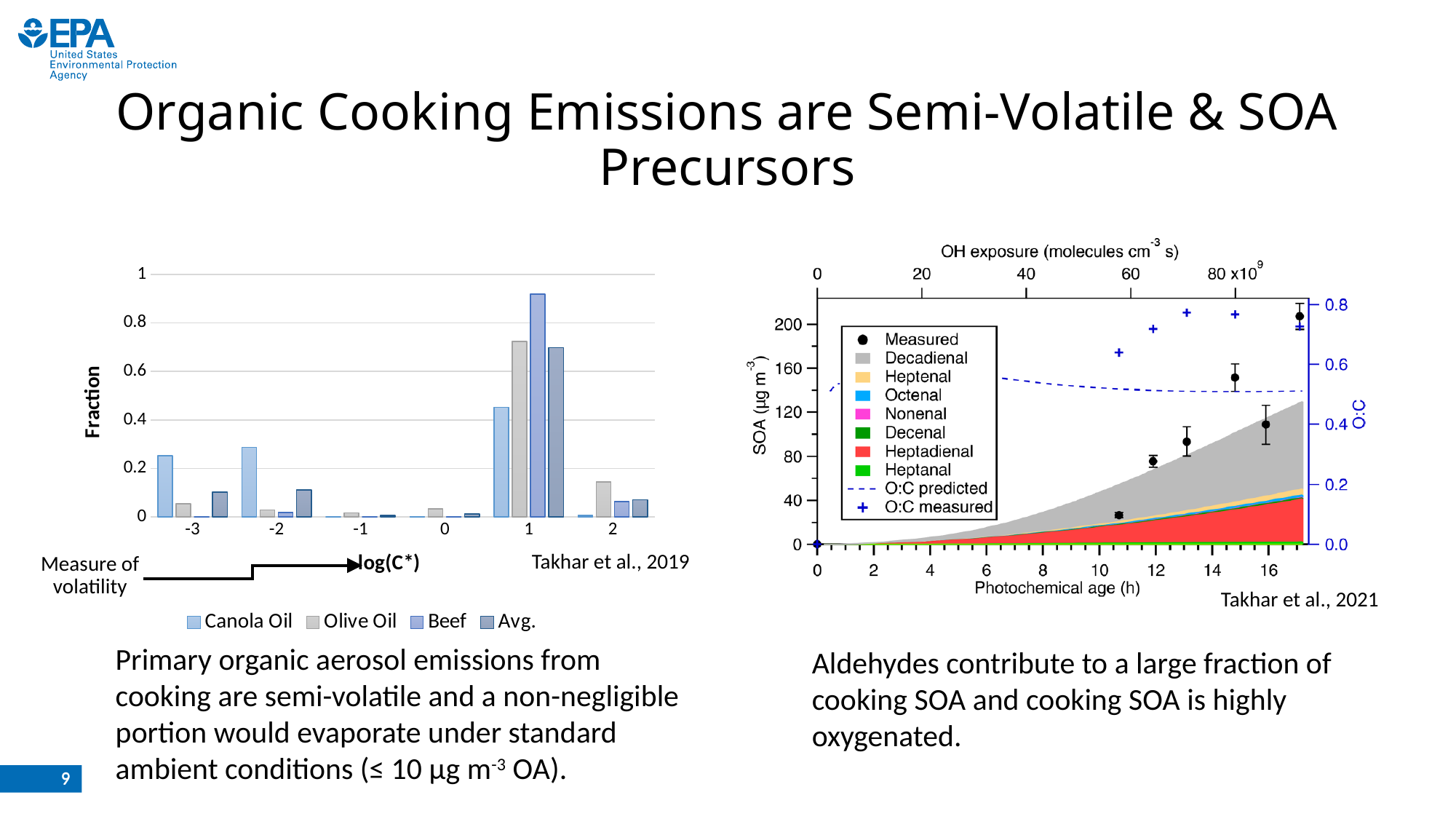
In the left chart (Fraction vs log(C*)), is the Canola Oil fraction at log(C*) = 1 greater or less than 0.6? less In the left chart (Fraction vs log(C*)), at which log(C*) value does Beef have its highest fraction? 1 In the left chart (Fraction vs log(C*)), which series has the larger fraction at log(C*) = -3, Canola Oil or Olive Oil? Canola Oil In the right chart (SOA vs Photochemical age), is the measured SOA at a photochemical age of about 15 h greater or less than 120? greater In the left chart (Fraction vs log(C*)), what kind of chart is it? bar chart In the left chart (Fraction vs log(C*)), how many series does the legend list? 4 In the left chart (Fraction vs log(C*)), what is the label of the y axis? Fraction In the right chart (SOA vs Photochemical age), do the measured SOA values rise or fall as photochemical age increases? rise In the left chart (Fraction vs log(C*)), which series has the highest fraction at log(C*) = 2? Olive Oil In the left chart (Fraction vs log(C*)), is the Beef fraction at log(C*) = 1 greater or less than 0.8? greater In the left chart (Fraction vs log(C*)), how many log(C*) categories are shown on the x axis? 6 In the right chart (SOA vs Photochemical age), how many entries does the legend list? 10